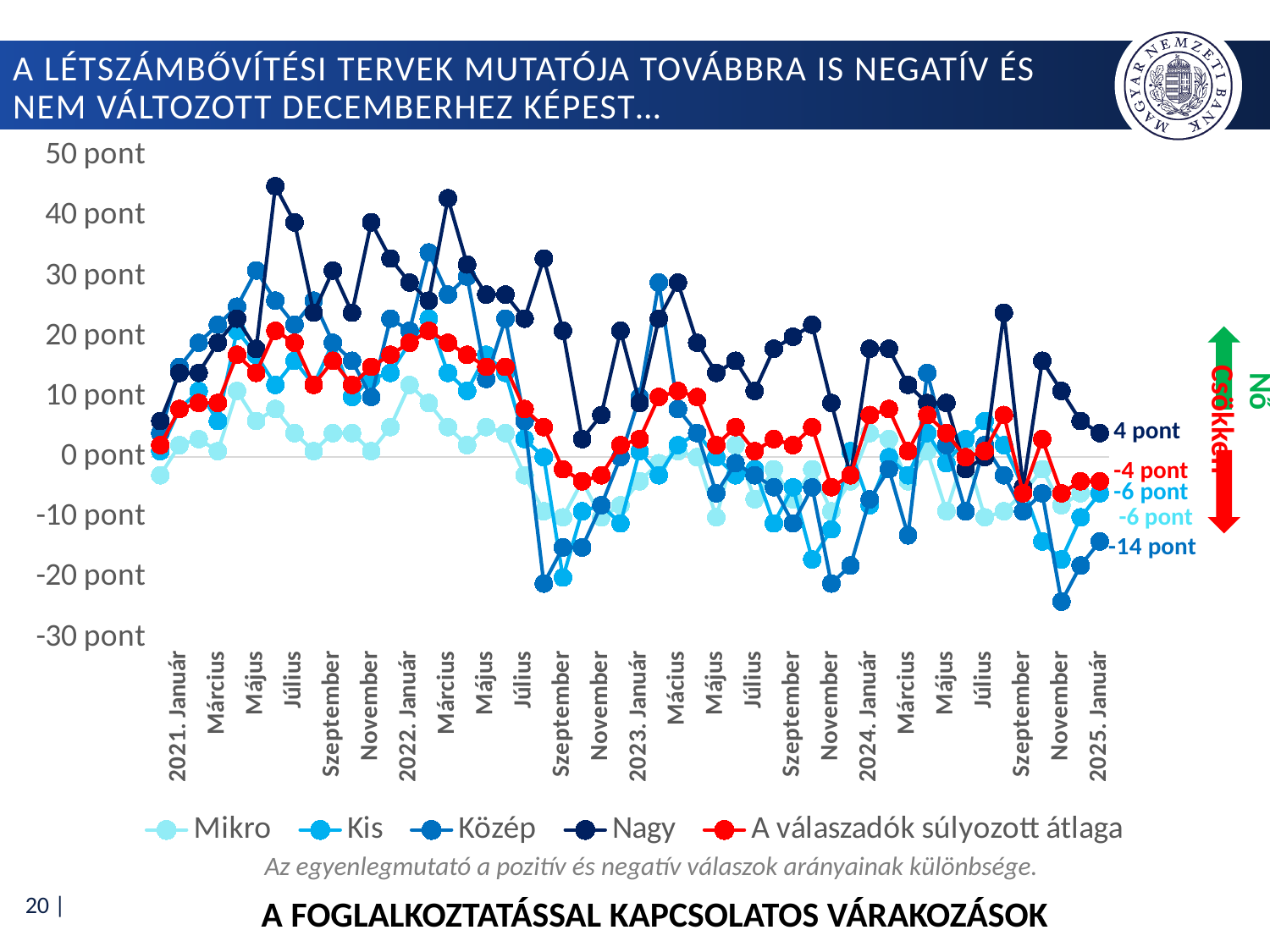
What is the value of the Közép series at 2025. Január? -14 pont What kind of chart is shown on the slide? line chart What is the value of 'A válaszadók súlyozott átlaga' at 2025. Január? -4 pont Which series has the highest value at 2025. Január? Nagy Is the value of 'A válaszadók súlyozott átlaga' at 2025. Január higher or lower than at 2021. Január? lower Which series has the lowest value at 2025. Január? Közép What colour is the line for 'A válaszadók súlyozott átlaga'? red How many series does the legend list? 5 What is the value of the Nagy series at 2025. Január? 4 pont What is the difference between the Nagy and Közép values at 2025. Január? 18 pont Is the value of the Nagy series at 2021. Január greater or less than 10 pont? greater What is the value of the Kis series at 2025. Január? -6 pont